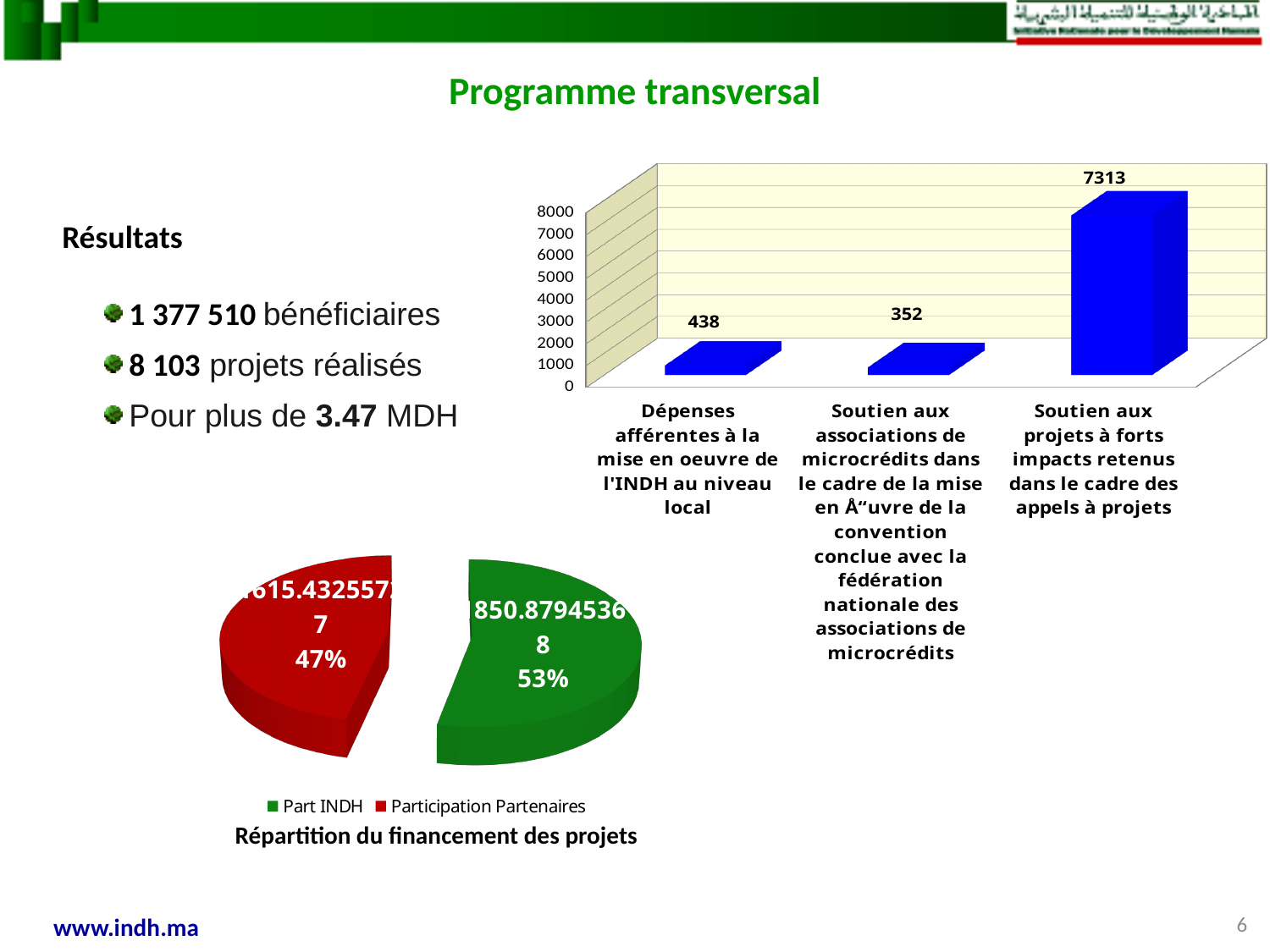
In the bar chart at the top right, what is the difference between the value for 'Dépenses afférentes à la mise en oeuvre de l'INDH au niveau local' and the value for 'Soutien aux associations de microcrédits'? 86 In the bar chart at the top right, what is the value for 'Soutien aux associations de microcrédits dans le cadre de la mise en œuvre de la convention conclue avec la fédération nationale des associations de microcrédits'? 352 What kind of chart is the chart at the top right of the slide? Bar chart In the pie chart 'Répartition du financement des projets', which slice is larger, 'Part INDH' or 'Participation Partenaires'? Part INDH In the bar chart at the top right, which category has the highest value? Soutien aux projets à forts impacts retenus dans le cadre des appels à projets In the bar chart at the top right, what is the value for 'Dépenses afférentes à la mise en oeuvre de l'INDH au niveau local'? 438 How many categories are shown in the bar chart at the top right? 3 In the pie chart 'Répartition du financement des projets', what share does 'Part INDH' represent? 53% In the bar chart at the top right, what is the difference between the value for 'Soutien aux projets à forts impacts' and the value for 'Dépenses afférentes à la mise en oeuvre de l'INDH au niveau local'? 6875 In the bar chart at the top right, which category has the lowest value? Soutien aux associations de microcrédits dans le cadre de la mise en œuvre de la convention conclue avec la fédération nationale des associations de microcrédits In the bar chart at the top right, what is the value for 'Soutien aux projets à forts impacts retenus dans le cadre des appels à projets'? 7313 In the pie chart 'Répartition du financement des projets', what share does 'Participation Partenaires' represent? 47%